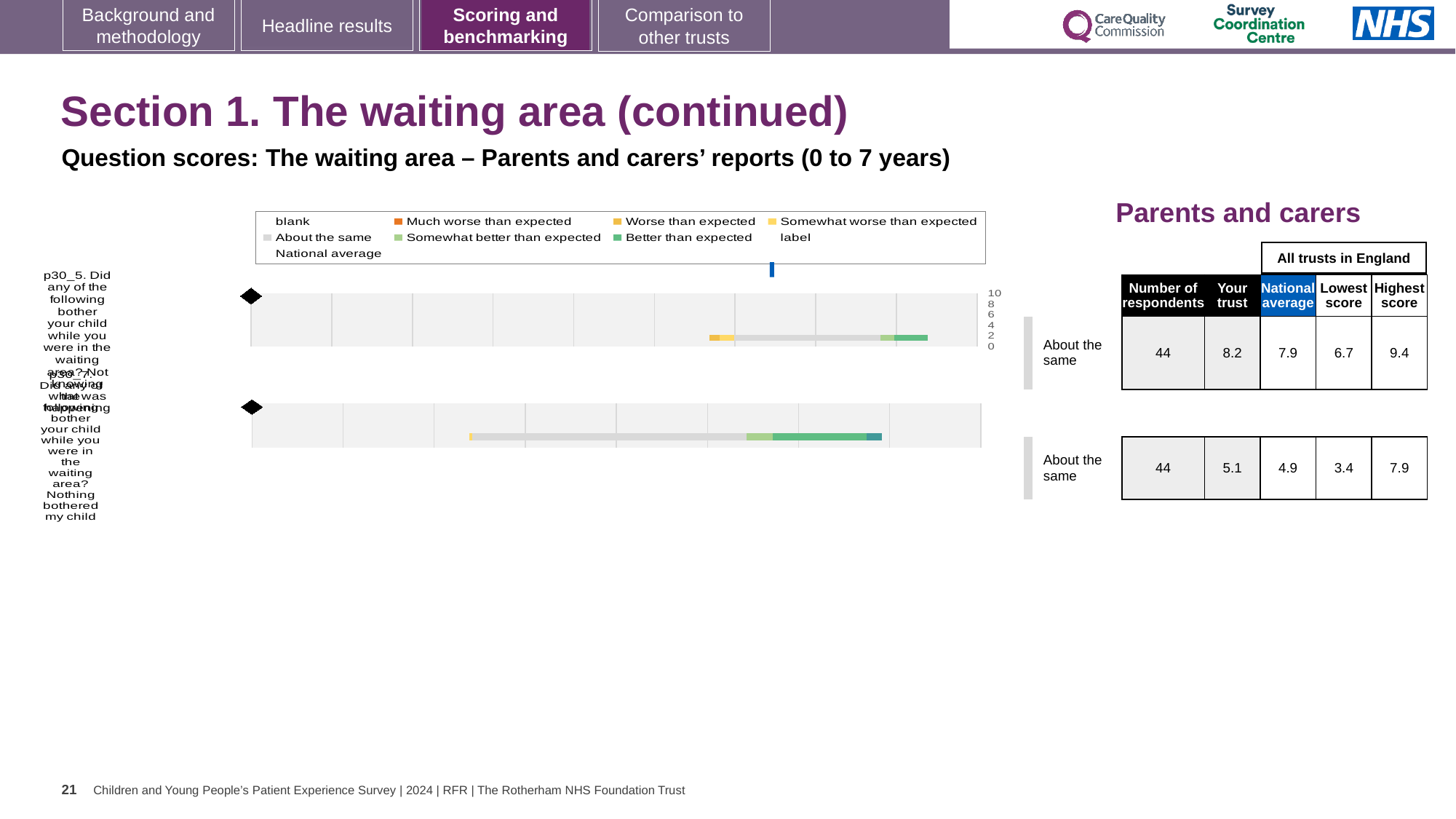
In the table next to the chart, what is the 'Your trust' score for the first question (p30_5, Not knowing what was happening)? 8.2 In the table next to the chart, what is the number of respondents for the first question (p30_5)? 44 What colour does the legend use for 'About the same'? light grey What colour does the legend use for 'Much worse than expected'? orange What kind of chart is used to show the question scores on this slide? bar chart What is the highest value shown on the chart's score axis? 10 In the table next to the chart, what is the difference between the highest score and the lowest score for question p30_7? 4.5 In the table next to the chart, which is larger for question p30_5: the 'Your trust' score or the national average? Your trust How many question bars (categories) are plotted in the chart? 2 In the table next to the chart, what is the national average for the second question (p30_7, Nothing bothered my child)? 4.9 In the table next to the chart, what benchmark category is given for both questions? About the same How many entries does the chart legend list? 9